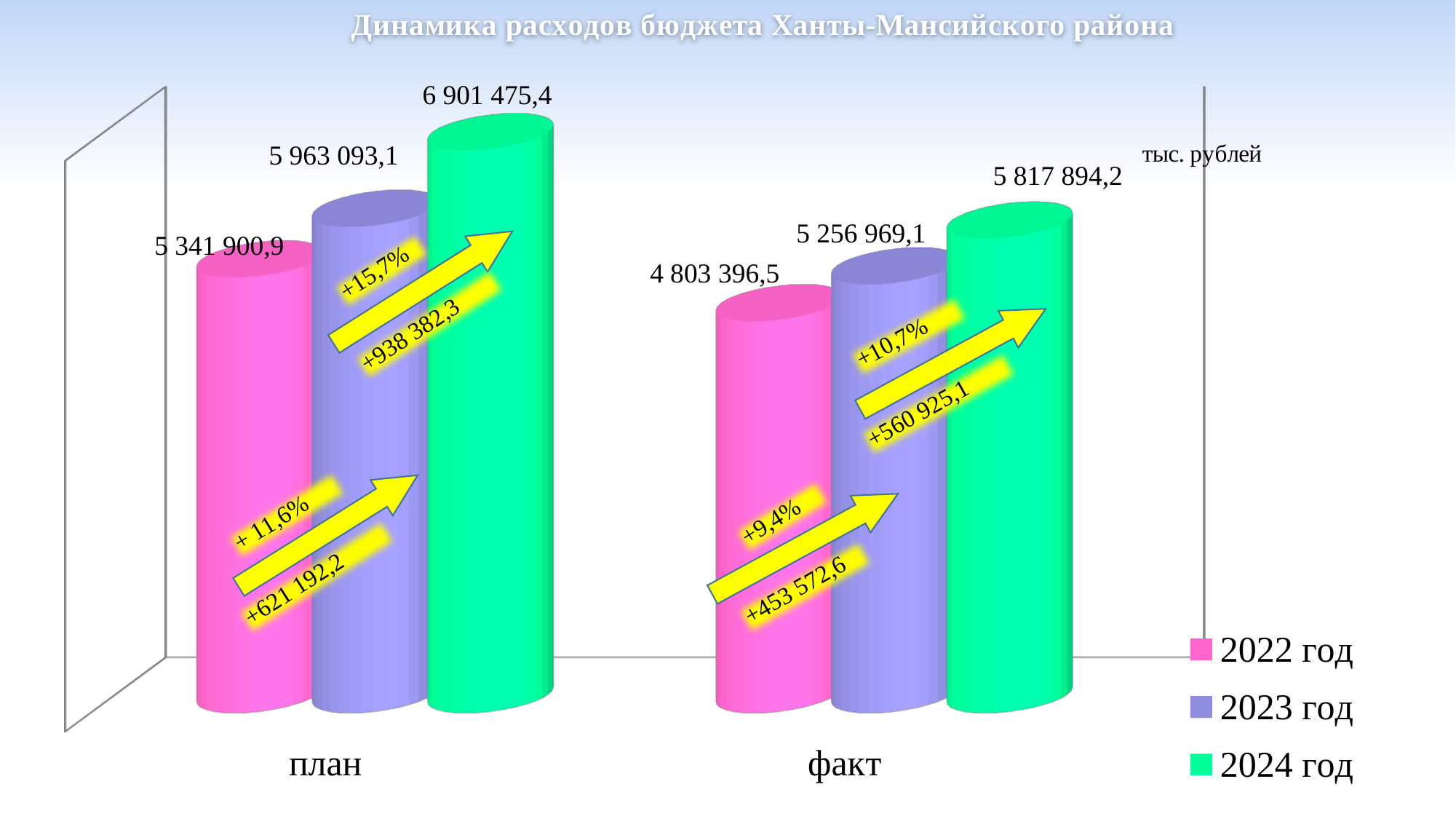
What is the value for 2022 год in the факт category? 4 803 396,5 What is the value for 2024 год in the факт category? 5 817 894,2 How many categories are shown on the x axis? 2 Which bar has the lowest value on the chart? 2022 год, факт What is the value for 2023 год in the план category? 5 963 093,1 What kind of chart is shown on the slide? bar chart What is the difference between the 2024 год and 2023 год values in the план category? 938 382,3 What is the difference between the 2024 год values for план and факт? 1 083 581,2 How many series does the legend list? 3 What is the value for 2024 год in the план category? 6 901 475,4 Which bar has the highest value on the chart? 2024 год, план Which is larger: the 2023 год value for план or the 2023 год value for факт? план